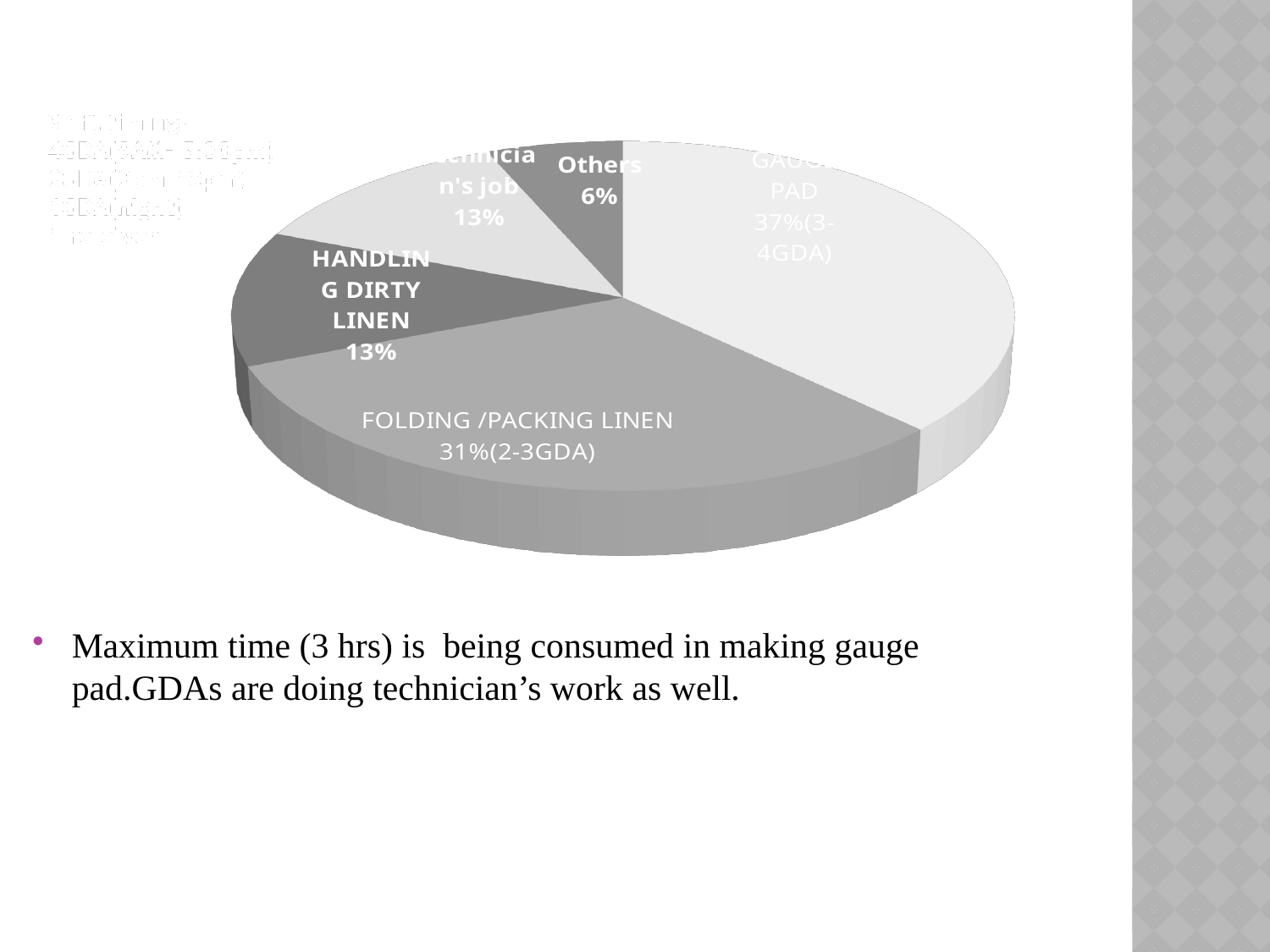
What percentage of the pie is labelled for GAUGE PAD? 37% Which is larger, the FOLDING /PACKING LINEN slice or the HANDLING DIRTY LINEN slice? FOLDING /PACKING LINEN What percentage of the pie is labelled for FOLDING /PACKING LINEN? 31% Which slice of the pie chart is the largest? GAUGE PAD What percentage of the pie is labelled for HANDLING DIRTY LINEN? 13% What is the difference in percentage points between the HANDLING DIRTY LINEN slice and the Others slice? 7 What is the difference in percentage points between the GAUGE PAD slice and the FOLDING /PACKING LINEN slice? 6 What kind of chart is shown on the slide? pie chart How many GDAs are indicated in the label of the GAUGE PAD slice? 3-4GDA Which slice of the pie chart is the smallest? Others How many slices does the pie chart have? 5